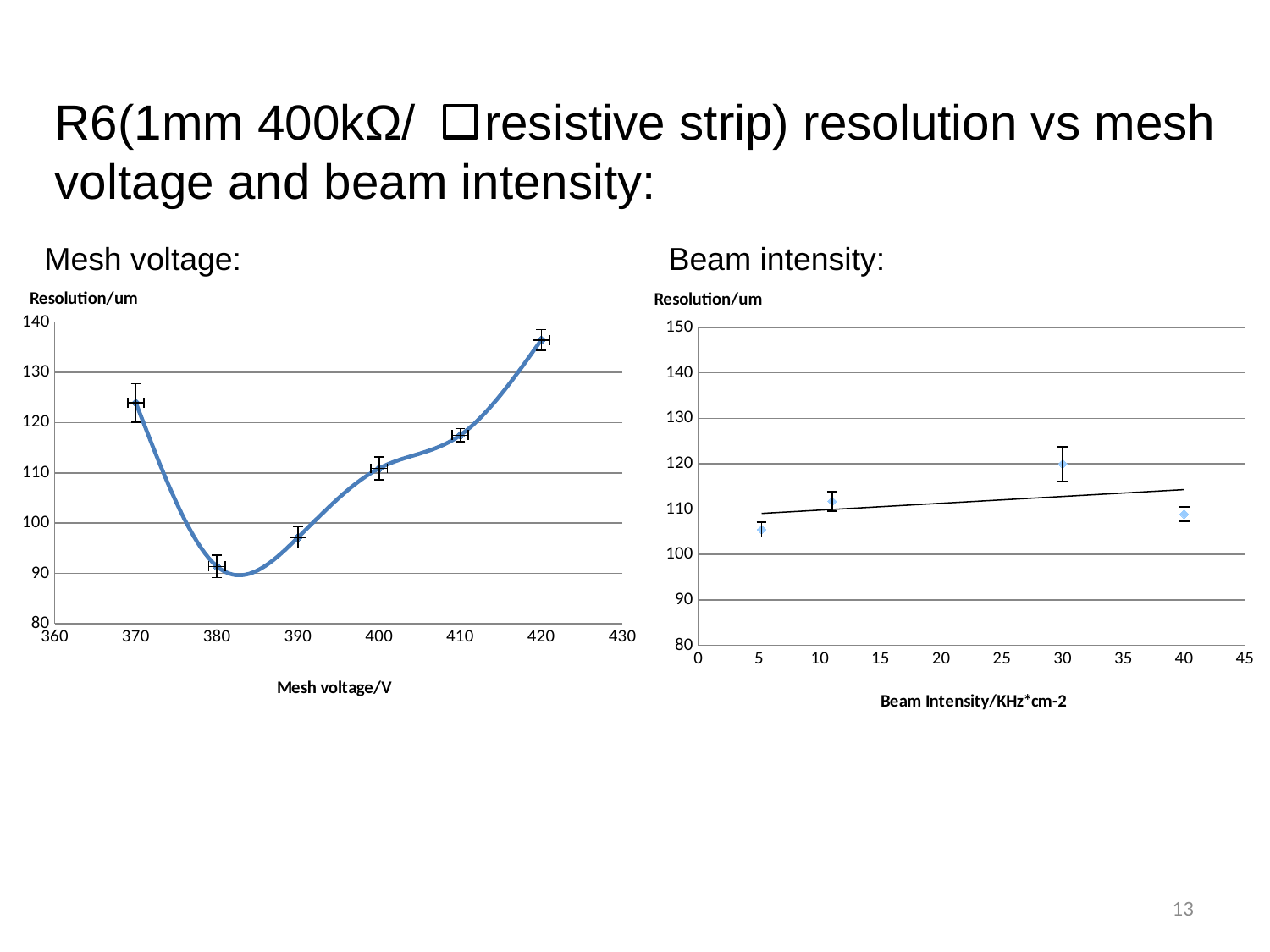
In the Mesh voltage chart, is the resolution at 380 V greater or less than 100? less In the Mesh voltage chart, at which mesh voltage is the resolution highest? 420 In the Mesh voltage chart, does the resolution rise or fall between 380 V and 420 V? rise What is the x-axis title of the Beam intensity chart? Beam Intensity/KHz*cm-2 In the Mesh voltage chart, is the resolution at 370 V greater or less than 120? greater How many data points are plotted in the Beam intensity chart? 4 In the Mesh voltage chart, which has the larger resolution: 400 V or 410 V? 410 V In the Mesh voltage chart, at which mesh voltage is the resolution lowest? 380 In the Mesh voltage chart, is the resolution at 420 V greater or less than 130? greater How many data points are plotted in the Mesh voltage chart? 6 What kind of chart is the Beam intensity chart? scatter chart